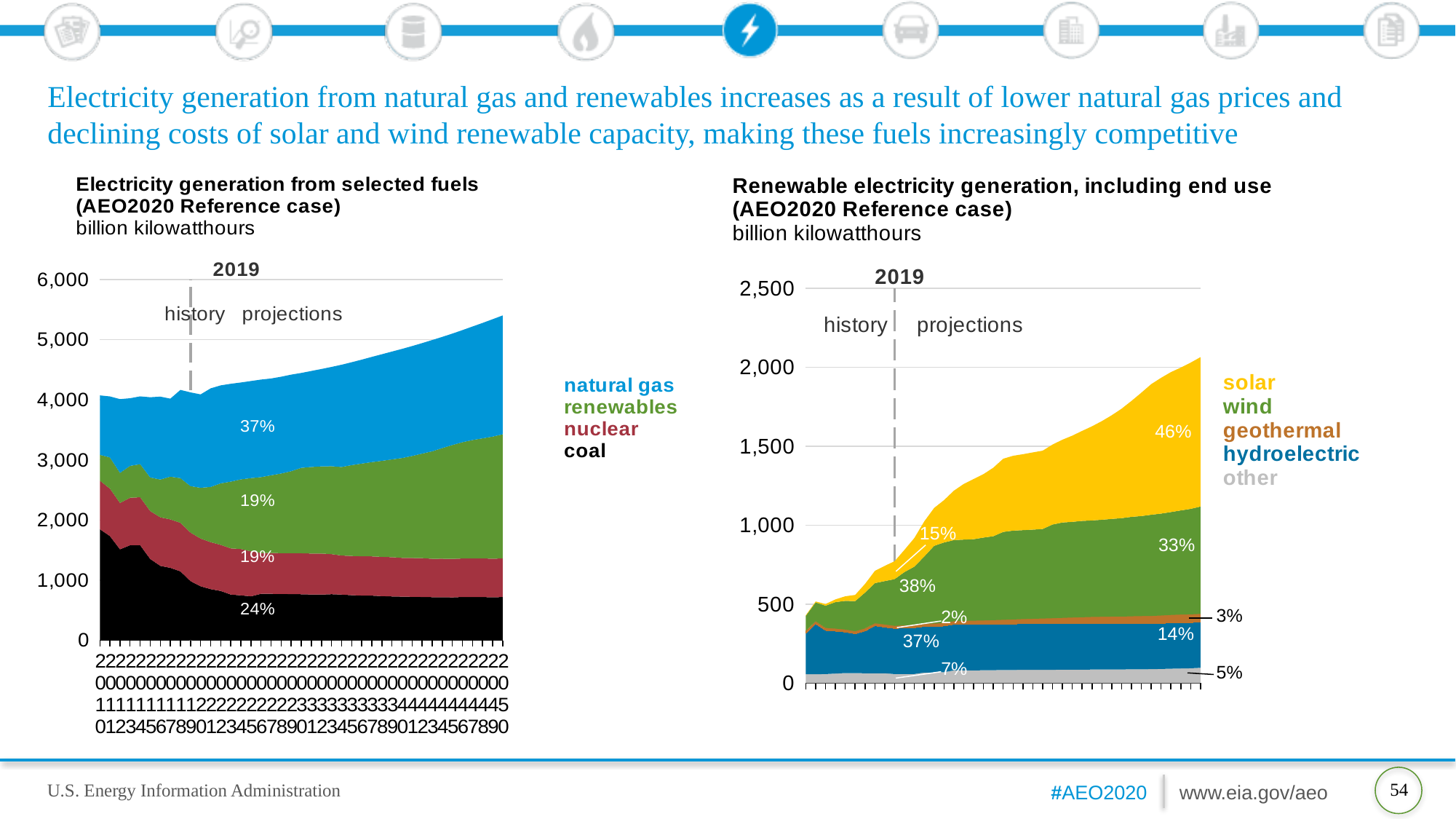
In the right chart, 'Renewable electricity generation, including end use', does total renewable generation rise or fall over the projection period? rise In the right chart, 'Renewable electricity generation, including end use', what is the difference between the solar label (46%) and the wind label (33%) at the end of the projection period? 13 percentage points In the right chart, 'Renewable electricity generation, including end use', what percentage label is shown for hydroelectric near the 2019 line? 37% What year does the dashed vertical line separating history from projections mark on both charts? 2019 In the left chart, 'Electricity generation from selected fuels', is the total generation at the end of the projection period greater or less than 5,000 billion kilowatthours? greater How many series does the legend of the right chart, 'Renewable electricity generation, including end use', list? 5 In the right chart, 'Renewable electricity generation, including end use', what percentage label is shown for solar at the end of the projection period? 46% In the left chart, 'Electricity generation from selected fuels', what percentage label is shown on the coal area? 24% In the left chart, 'Electricity generation from selected fuels', what percentage label is shown on the natural gas area? 37% How many series does the legend of the left chart, 'Electricity generation from selected fuels', list? 4 What kind of chart is the left chart, 'Electricity generation from selected fuels'? Stacked area chart In the right chart, 'Renewable electricity generation, including end use', which has the larger share label at the end of the projection period, solar or wind? solar